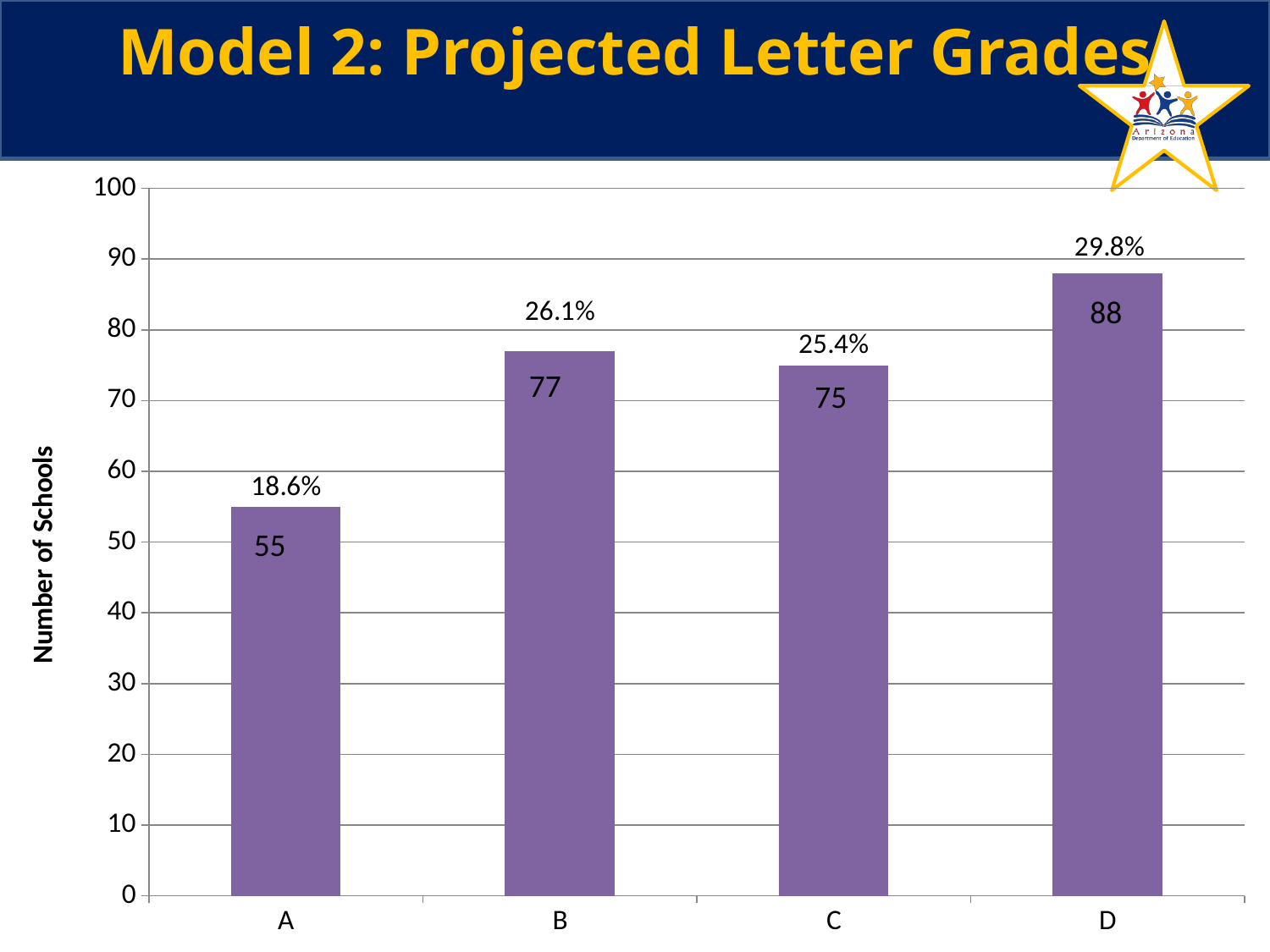
Which letter grade has the highest number of schools? D Which letter grade has the lowest number of schools? A What is the title of the slide? Model 2: Projected Letter Grades How many schools are projected to receive a letter grade of A? 55 What percentage of schools is shown above the bar for grade D? 29.8% Is the number of schools for grade B greater or less than 70? greater What is the difference in the number of schools between grade D and grade A? 33 What type of chart is shown on the slide? bar chart How many letter grade categories are shown on the x axis? 4 Which has more schools, grade B or grade C? B What is the label of the vertical axis? Number of Schools How many schools are projected to receive a letter grade of C? 75